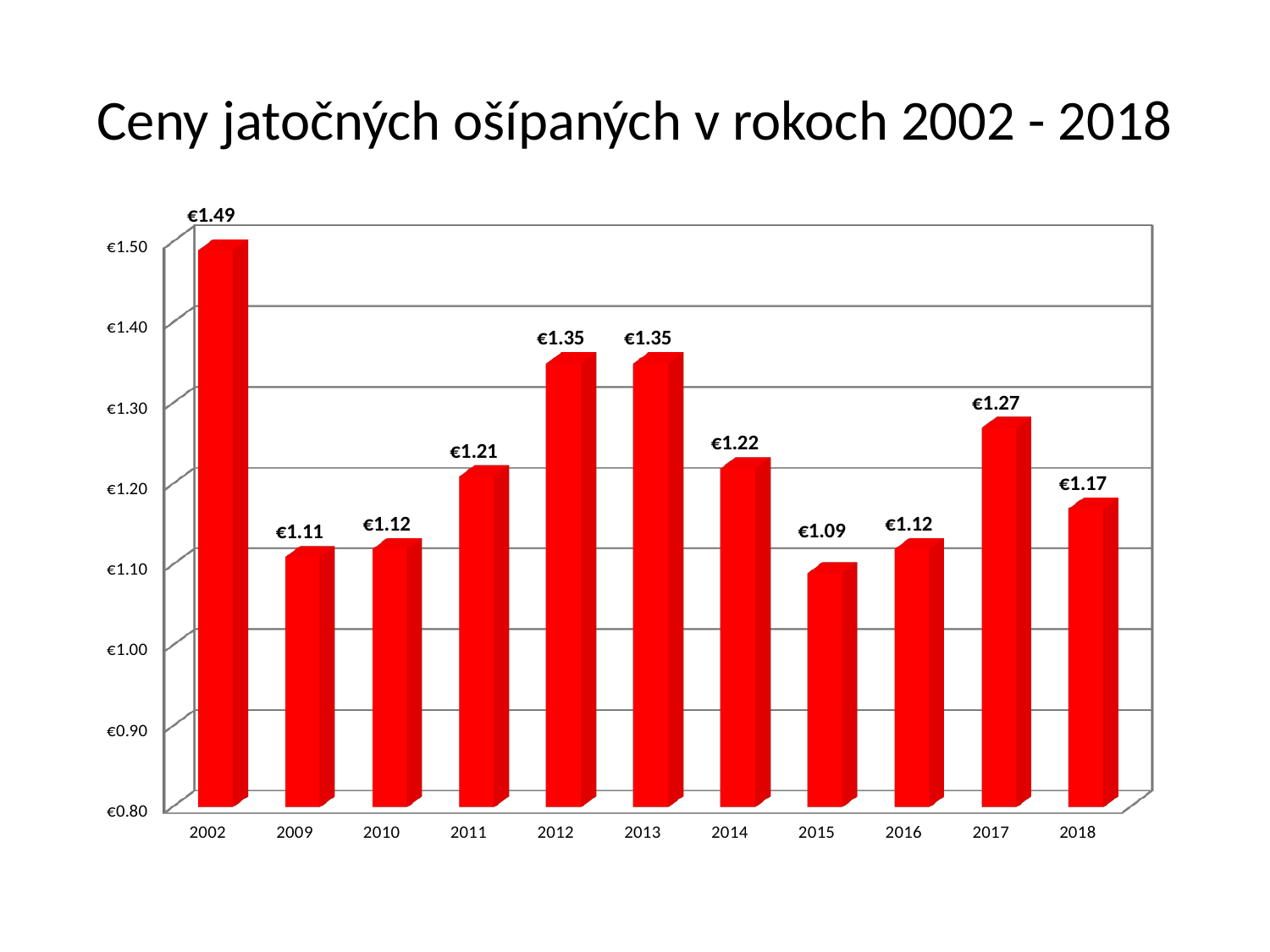
What is the title of the slide? Ceny jatočných ošípaných v rokoch 2002 - 2018 How many years are shown on the x axis? 11 Which year has the highest value? 2002 Is the value for 2013 greater or less than €1.30? greater What is the difference between the values for 2017 and 2016? €0.15 What is the value for 2002? €1.49 What is the difference between the values for 2002 and 2018? €0.32 What kind of chart is shown on the slide? bar chart Which year has the lowest value? 2015 Which is larger, the value for 2011 or the value for 2014? 2014 What is the value for 2015? €1.09 What is the value for 2017? €1.27